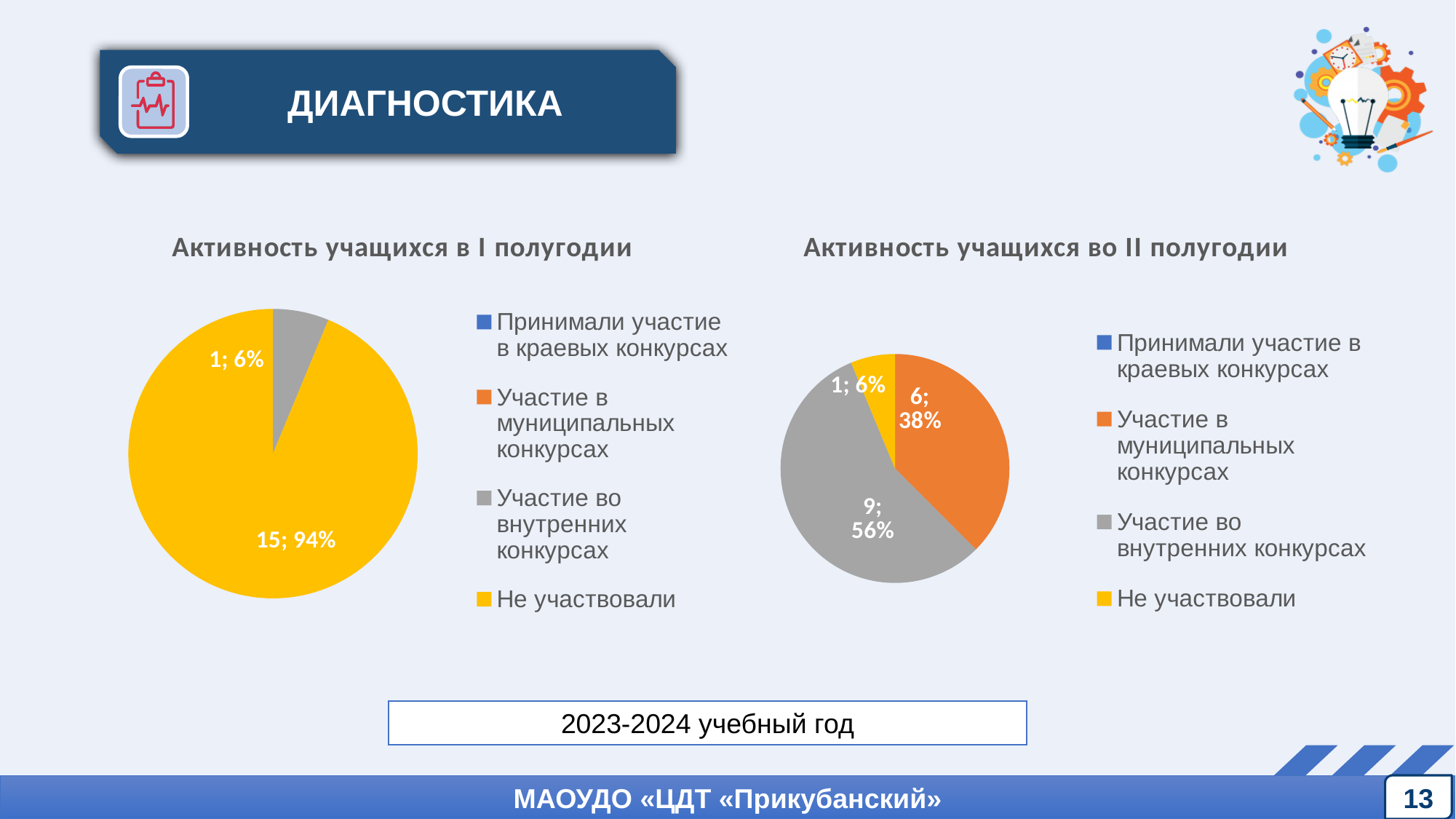
In the chart 'Активность учащихся во II полугодии', what value is shown for 'Не участвовали'? 1; 6% In the chart 'Активность учащихся во II полугодии', what is the difference in count between 'Участие во внутренних конкурсах' and 'Участие в муниципальных конкурсах'? 3 In the chart 'Активность учащихся во II полугодии', what share of the pie does 'Участие во внутренних конкурсах' take? 56% In the chart 'Активность учащихся во II полугодии', what value is shown for 'Участие во внутренних конкурсах'? 9; 56% How many entries does the legend of the chart 'Активность учащихся во II полугодии' list? 4 In the chart 'Активность учащихся во II полугодии', what value is shown for 'Участие в муниципальных конкурсах'? 6; 38% What type of chart is 'Активность учащихся в I полугодии'? Pie chart In the chart 'Активность учащихся в I полугодии', what value is shown for 'Участие во внутренних конкурсах'? 1; 6% In the chart 'Активность учащихся во II полугодии', which is larger: 'Участие в муниципальных конкурсах' or 'Не участвовали'? Участие в муниципальных конкурсах In the chart 'Активность учащихся в I полугодии', which category has the largest slice? Не участвовали In the chart 'Активность учащихся в I полугодии', what value is shown for 'Не участвовали'? 15; 94% In the chart 'Активность учащихся во II полугодии', which category has the largest slice? Участие во внутренних конкурсах